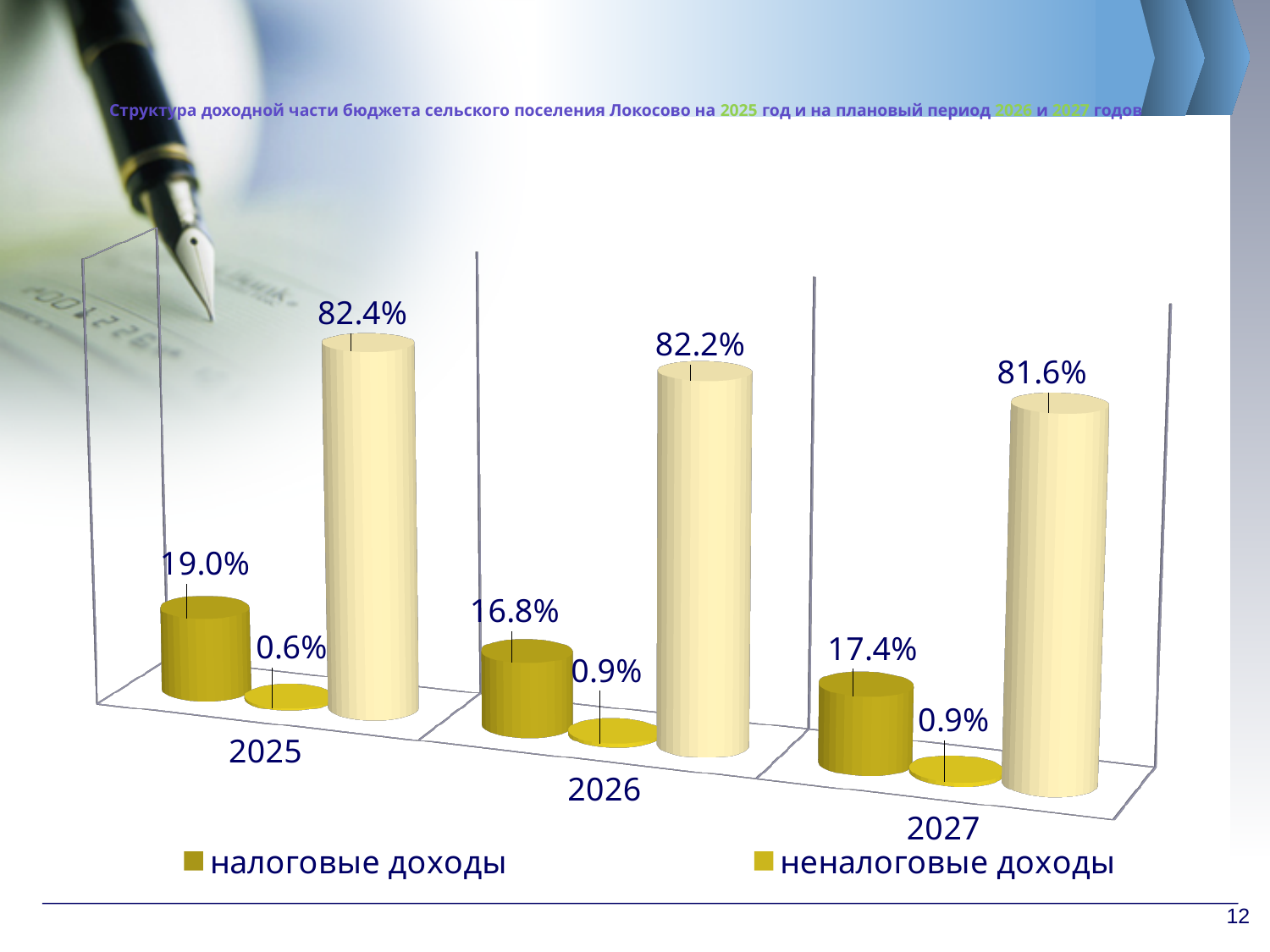
What kind of chart is shown on the slide? bar chart In which year is the value for налоговые доходы highest? 2025 Which series is shown in the darker yellow colour in the legend? налоговые доходы How many years (categories) are shown on the x axis? 3 How many series does the legend list? 2 What is the difference between the налоговые доходы values for 2025 and 2026? 2.2% What is the value for налоговые доходы in 2025? 19.0% What is the value for неналоговые доходы in 2026? 0.9% What is the value for неналоговые доходы in 2025? 0.6% Which is larger: налоговые доходы in 2027 or налоговые доходы in 2026? налоговые доходы in 2027 In which year is the value for налоговые доходы lowest? 2026 What is the value for налоговые доходы in 2027? 17.4%